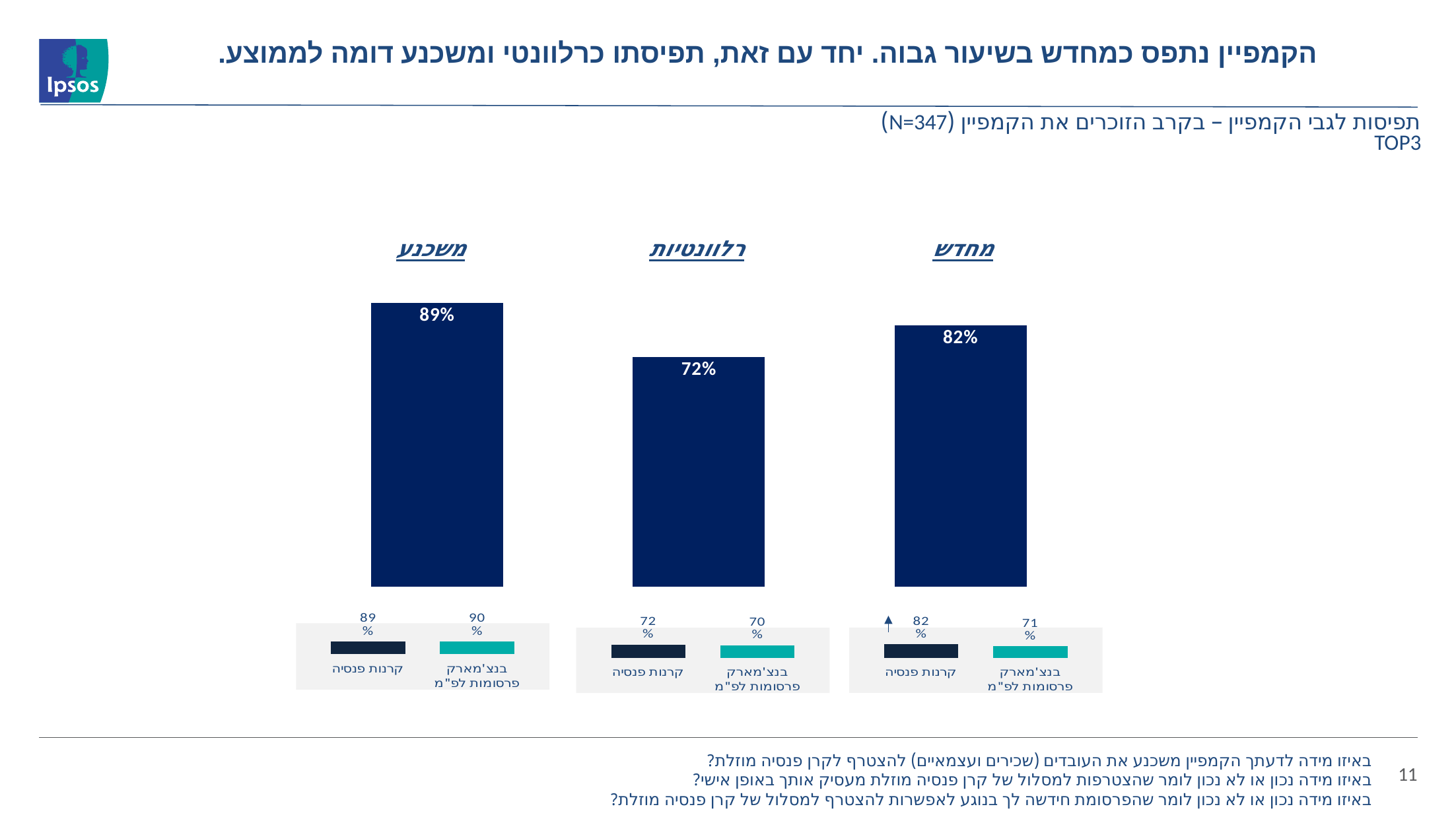
In the benchmark box under מחדש, what is the value for קרנות פנסיה? 82% How many main bars are shown in the chart? 3 Which of the three main bars (משכנע, רלוונטיות, מחדש) has the lowest value? רלוונטיות Which of the three main bars (משכנע, רלוונטיות, מחדש) has the highest value? משכנע What is the value shown for מחדש in the main chart? 82% What is the value shown for רלוונטיות in the main chart? 72% In the benchmark box under משכנע, what is the value for בנצ'מארק פרסומות לפ"מ? 90% What is the difference between the משכנע value and the רלוונטיות value in the main chart? 17% Which is larger in the main chart: the value for מחדש or the value for רלוונטיות? מחדש What is the value shown for משכנע in the main chart? 89% In the benchmark box under מחדש, what is the value for בנצ'מארק פרסומות לפ"מ? 71% What kind of chart is used to show the משכנע, רלוונטיות and מחדש values? Bar chart